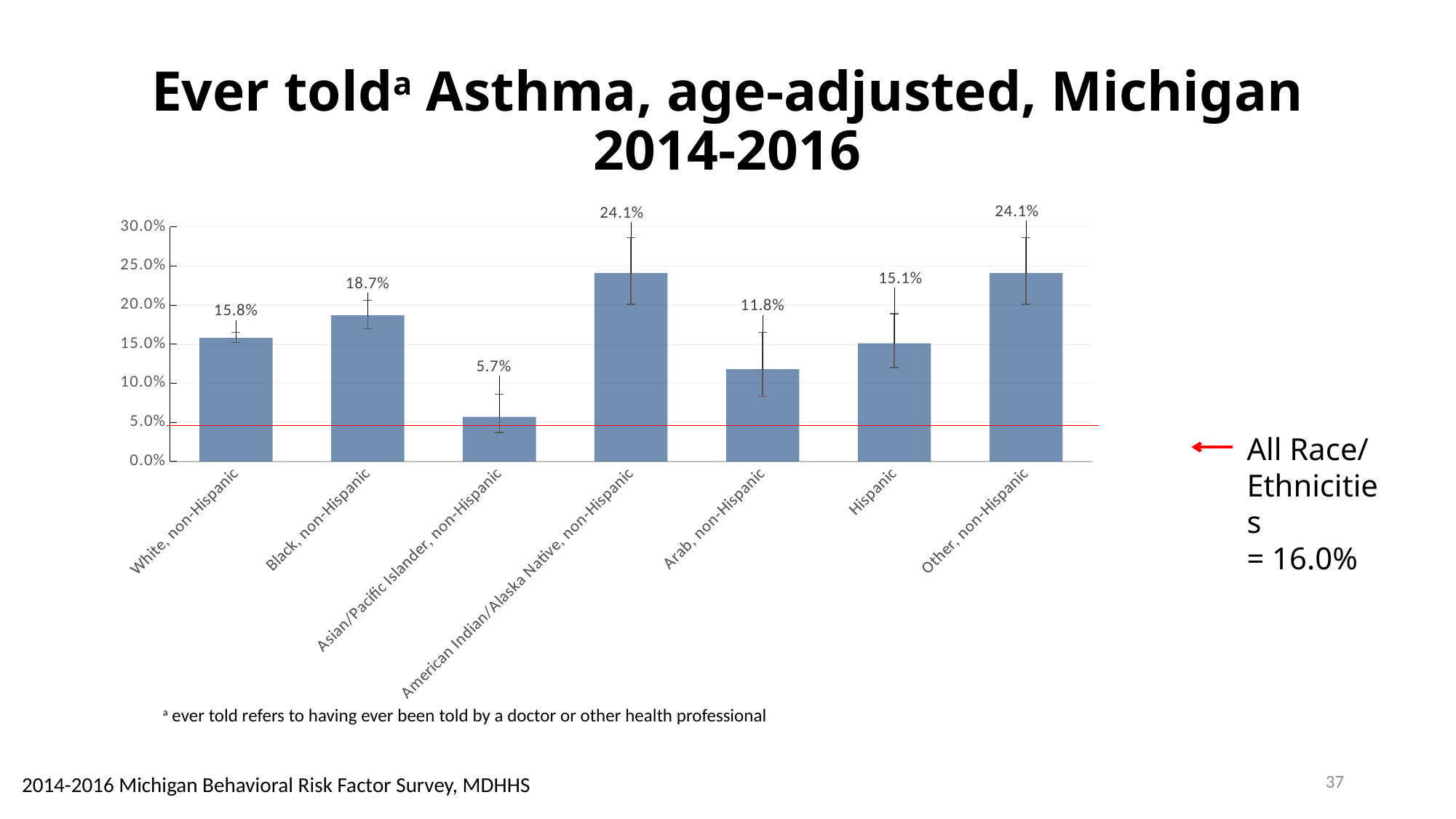
Which category has the lowest value? Asian/Pacific Islander, non-Hispanic What is the value for American Indian/Alaska Native, non-Hispanic? 24.1% How many race/ethnicity categories are shown on the chart? 7 What is the value for Asian/Pacific Islander, non-Hispanic? 5.7% What is the value for Hispanic? 15.1% What is the value for Black, non-Hispanic? 18.7% What value does the slide give for All Race/Ethnicities? 16.0% What is the value for Arab, non-Hispanic? 11.8% What is the difference between the values for Black, non-Hispanic and White, non-Hispanic? 2.9% What kind of chart is shown on the slide? Bar chart What is the difference between the values for Other, non-Hispanic and Arab, non-Hispanic? 12.3% Which is larger, the value for White, non-Hispanic or the value for Hispanic? White, non-Hispanic